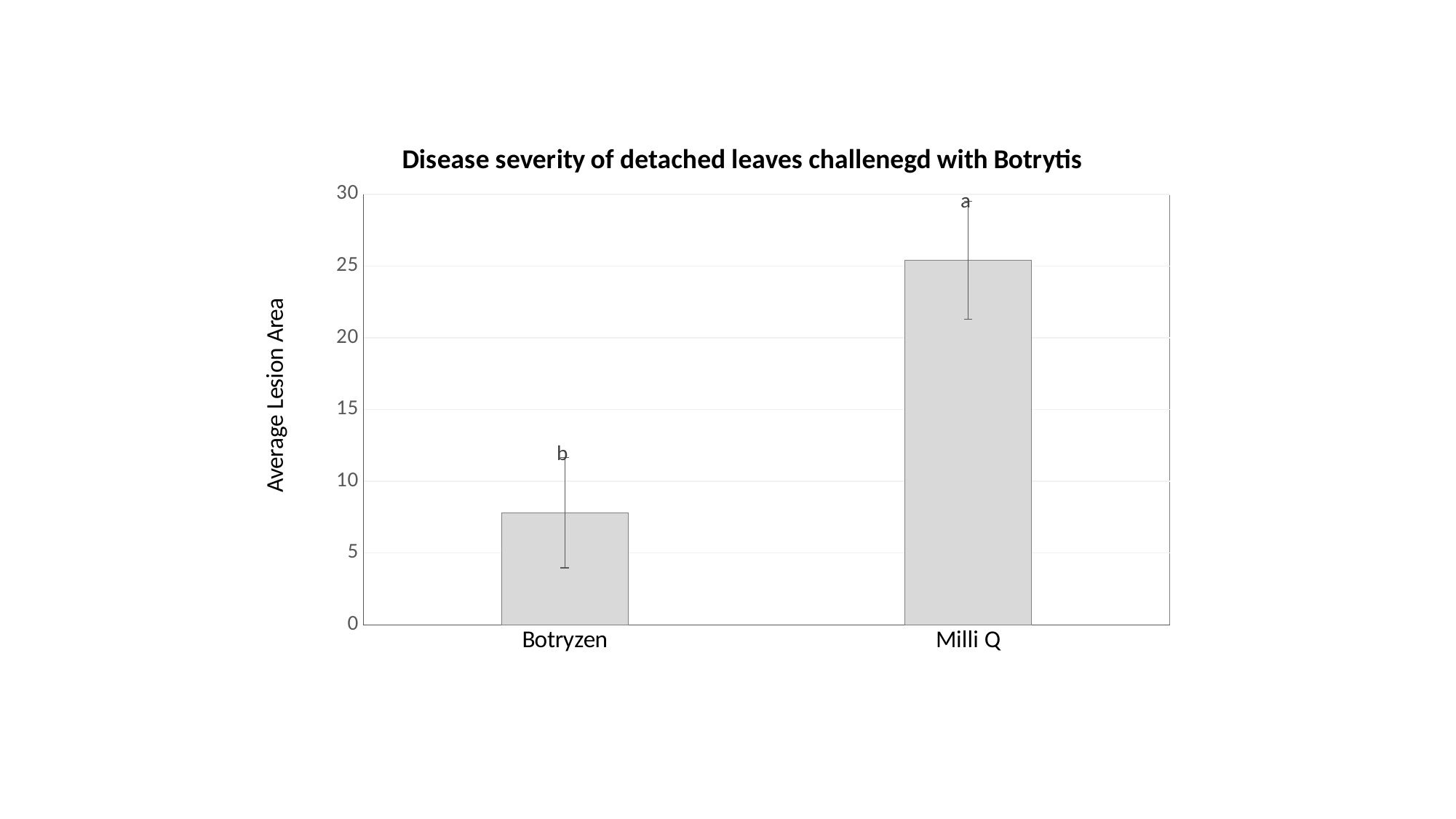
Is the value for Botryzen greater or less than 5? greater Is the value for Botryzen greater or less than 10? less What is the maximum value shown on the y axis? 30 Which category has the highest average lesion area? Milli Q What is the label of the y axis? Average Lesion Area Which category has the lowest average lesion area? Botryzen Is the value for Milli Q greater or less than 20? greater Which has a larger average lesion area, Botryzen or Milli Q? Milli Q How many categories are plotted on the x axis? 2 What is the title of the chart? Disease severity of detached leaves challenegd with Botrytis What kind of chart is shown on the slide? bar chart